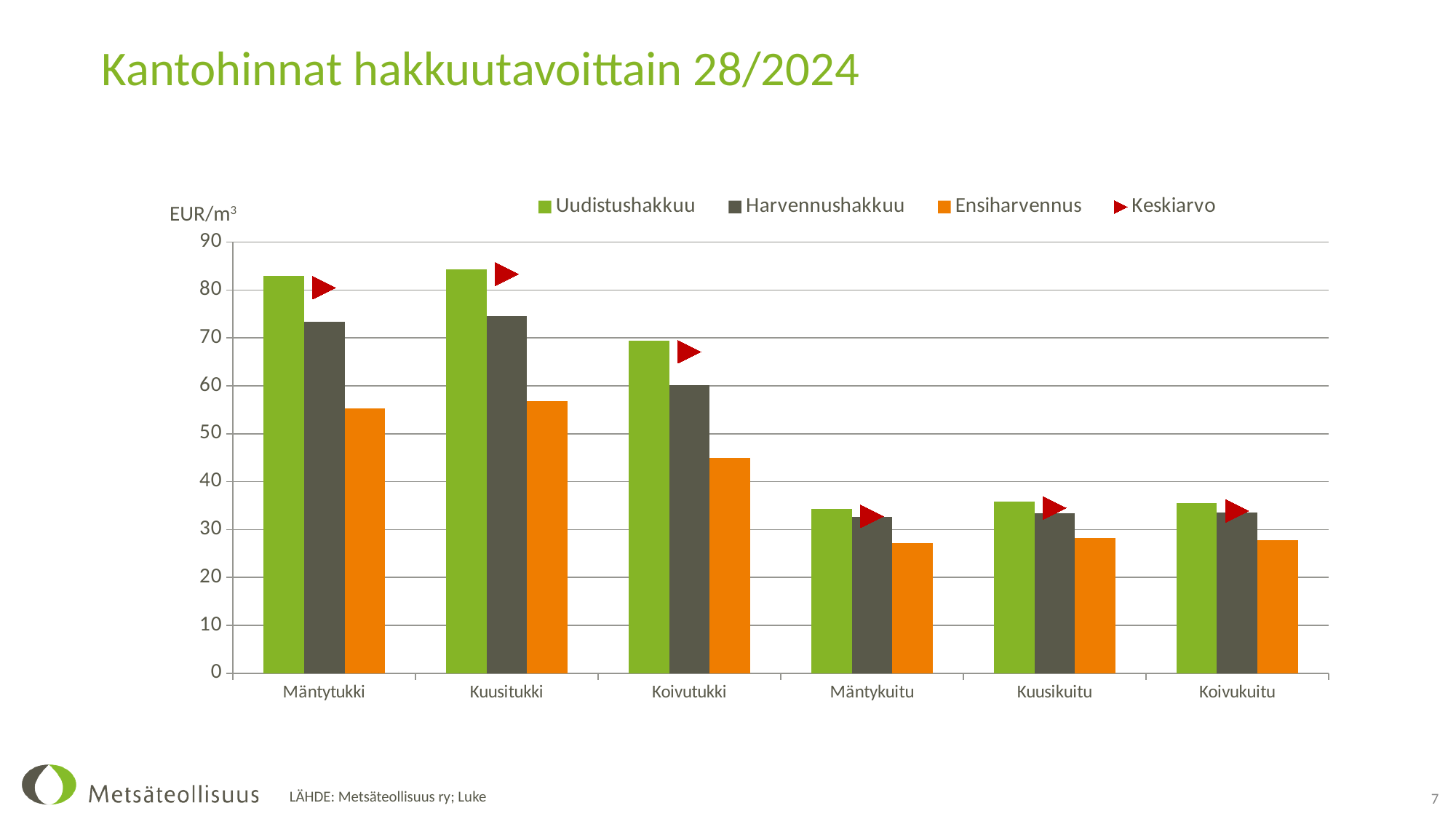
Is the Harvennushakkuu value for Kuusitukki greater or less than 70? greater What kind of chart is shown on the slide? bar chart How many categories are shown on the x axis? 6 Is the Uudistushakkuu value for Mäntytukki greater or less than 80? greater How many series does the legend list? 4 Which is larger, the Uudistushakkuu value for Mäntytukki or for Koivutukki? Mäntytukki What is the title of the chart? Kantohinnat hakkuutavoittain 28/2024 Which is larger, the Harvennushakkuu value for Koivutukki or for Kuusikuitu? Koivutukki Is the Ensiharvennus value for Mäntykuitu greater or less than 30? less What unit is shown on the y axis? EUR/m³